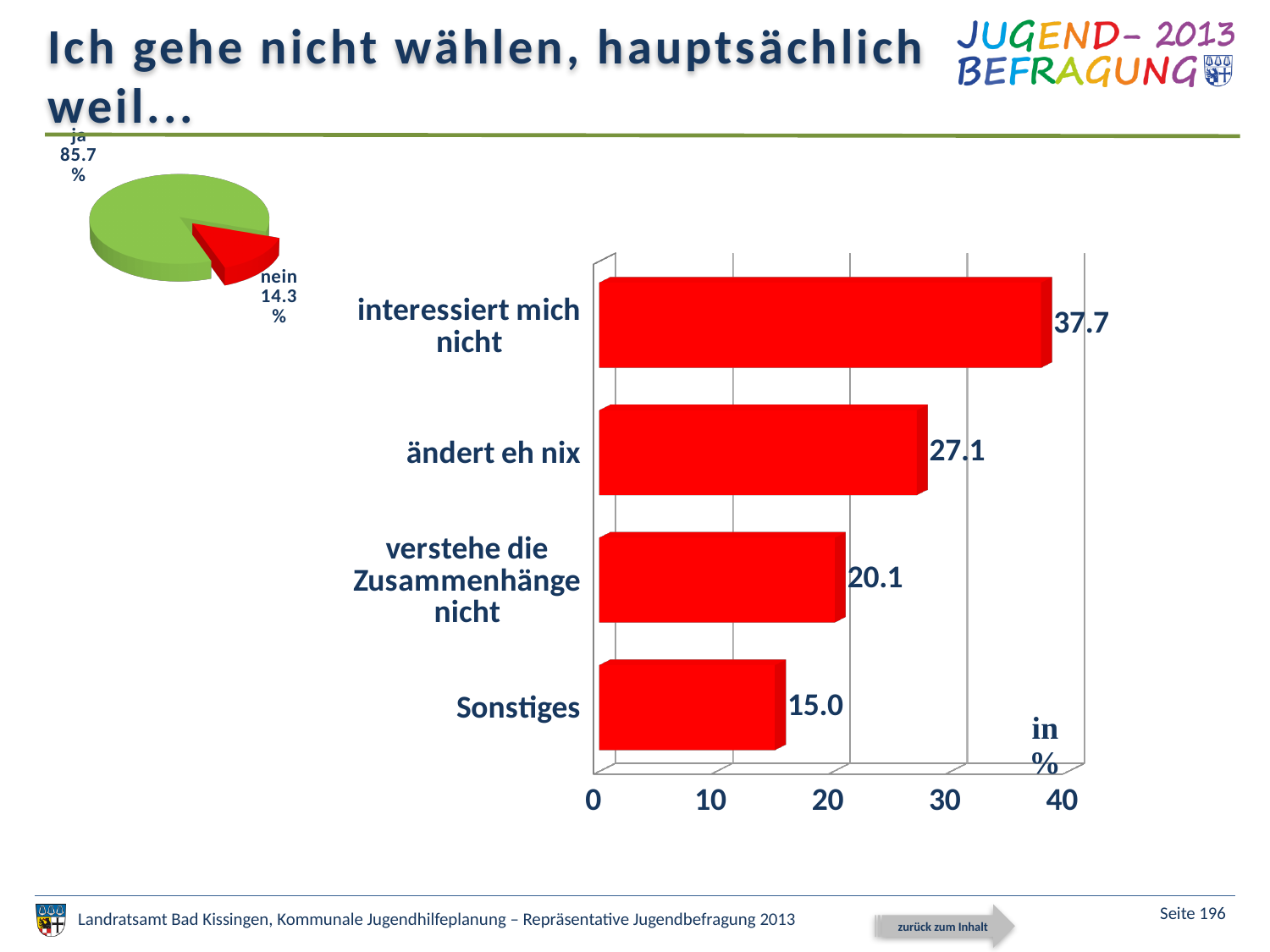
In the bar chart, which is larger: "verstehe die Zusammenhänge nicht" or "Sonstiges"? verstehe die Zusammenhänge nicht In the bar chart, what is the difference between "interessiert mich nicht" and "ändert eh nix"? 10.6 In the bar chart, what is the value for "ändert eh nix"? 27.1 In the bar chart, which category has the lowest value? Sonstiges In the bar chart, which category has the highest value? interessiert mich nicht In the pie chart on the left, what is the share for "nein"? 14.3 % In the bar chart, what is the value for "verstehe die Zusammenhänge nicht"? 20.1 How many categories does the bar chart show? 4 In the bar chart, what is the value for "Sonstiges"? 15.0 In the bar chart, what is the value for "interessiert mich nicht"? 37.7 In the pie chart on the left, what is the share for "ja"? 85.7 % What kind of chart is the chart on the right side of the slide? bar chart